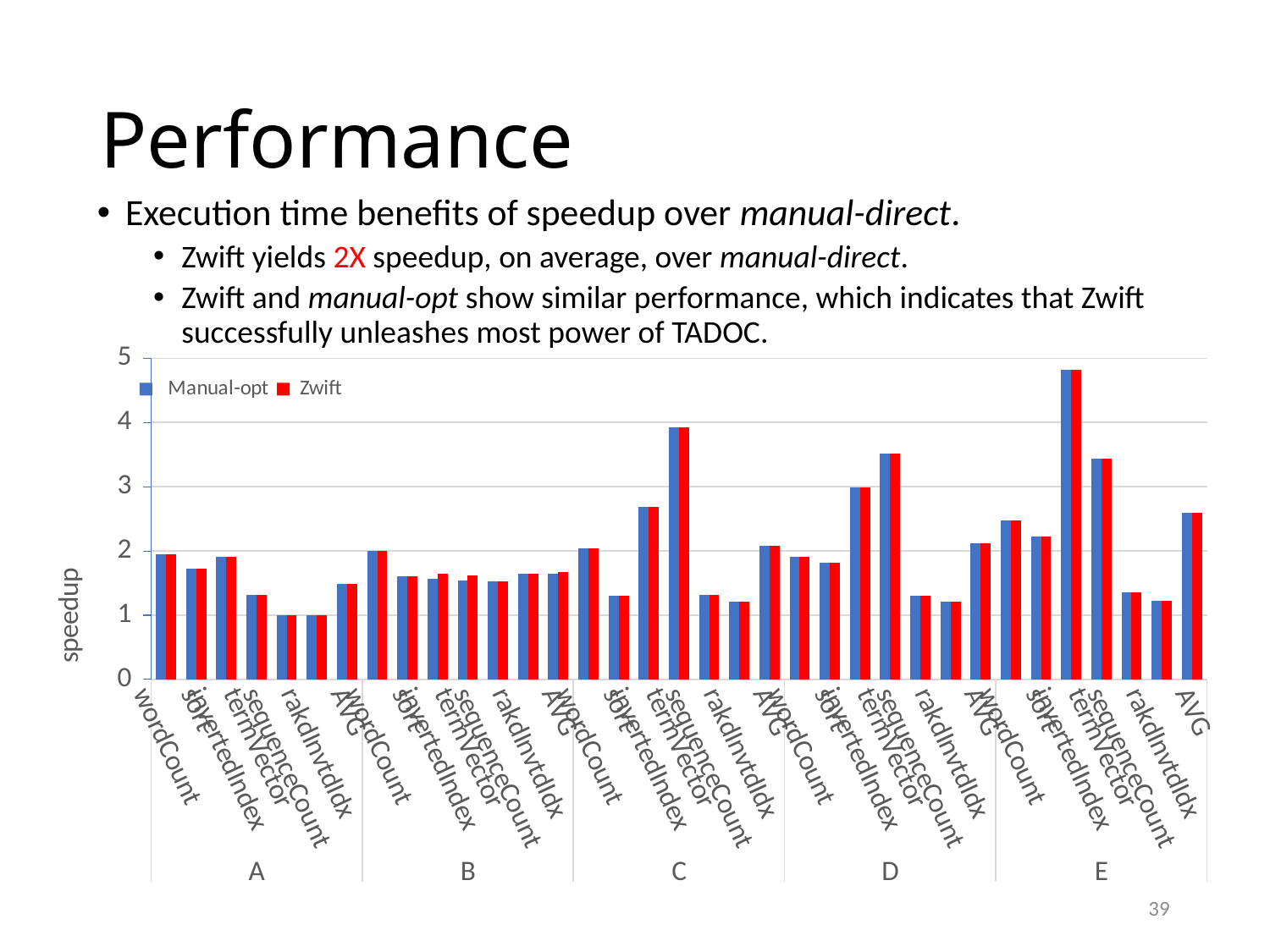
Which benchmark has the highest speedup in the chart? invertedIndex in group E What are the two series named in the legend? Manual-opt and Zwift How many series does the legend list? 2 How many dataset groups (A, B, C, ...) are shown along the x axis? 5 Is the Zwift speedup for sequenceCount in group C greater or less than 3? less Is the Zwift speedup for AVG in group A greater or less than 2? less Is the Zwift speedup for AVG in group E greater or less than 2? greater What kind of chart is shown on the slide? bar chart What is the label of the y axis? speedup